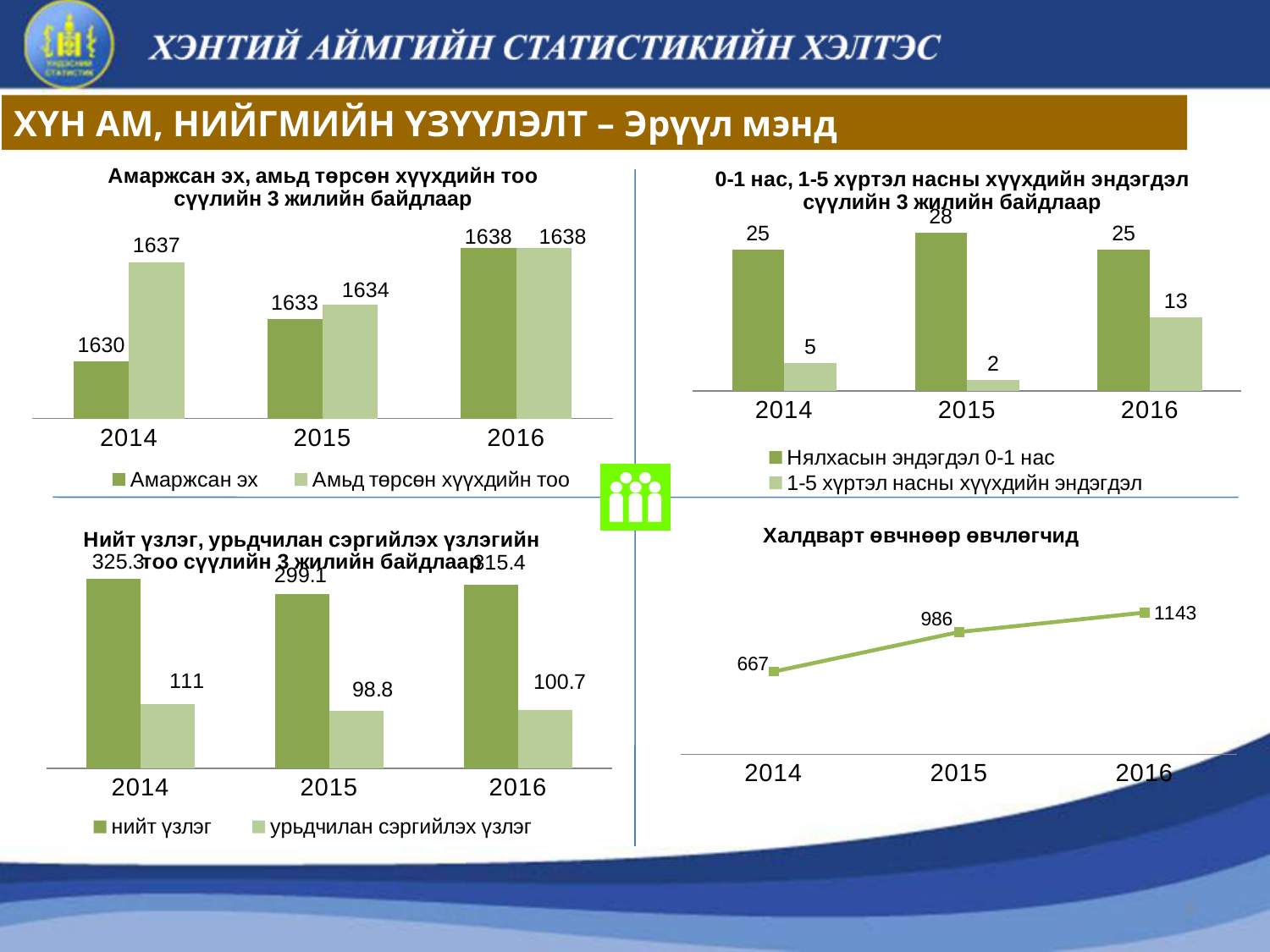
In the top-left chart (Амаржсан эх, амьд төрсөн хүүхдийн тоо), what is the value for Амьд төрсөн хүүхдийн тоо in 2015? 1634 In the top-left chart (Амаржсан эх, амьд төрсөн хүүхдийн тоо), what is the difference between Амьд төрсөн хүүхдийн тоо and Амаржсан эх in 2014? 7 In the bottom-left chart (Нийт үзлэг, урьдчилан сэргийлэх үзлэгийн тоо), what is the value for нийт үзлэг in 2015? 299.1 In the top-left chart (Амаржсан эх, амьд төрсөн хүүхдийн тоо), what is the value for Амаржсан эх in 2014? 1630 In the bottom-right chart (Халдварт өвчнөөр өвчлөгчид), what is the value for 2015? 986 In the top-right chart (0-1 нас, 1-5 хүртэл насны хүүхдийн эндэгдэл), which year has the lowest value for 1-5 хүртэл насны хүүхдийн эндэгдэл? 2015 What kind of chart is the bottom-right chart (Халдварт өвчнөөр өвчлөгчид)? Line chart In the top-right chart (0-1 нас, 1-5 хүртэл насны хүүхдийн эндэгдэл), which year has the highest value for Нялхасын эндэгдэл 0-1 нас? 2015 In the top-right chart (0-1 нас, 1-5 хүртэл насны хүүхдийн эндэгдэл), what is the value for 1-5 хүртэл насны хүүхдийн эндэгдэл in 2016? 13 In the bottom-left chart (Нийт үзлэг, урьдчилан сэргийлэх үзлэгийн тоо), which is larger: урьдчилан сэргийлэх үзлэг in 2014 or in 2016? 2014 In the bottom-right chart (Халдварт өвчнөөр өвчлөгчид), do the values rise or fall from 2014 to 2016? Rise In the bottom-left chart (Нийт үзлэг, урьдчилан сэргийлэх үзлэгийн тоо), how many series does the legend list? 2